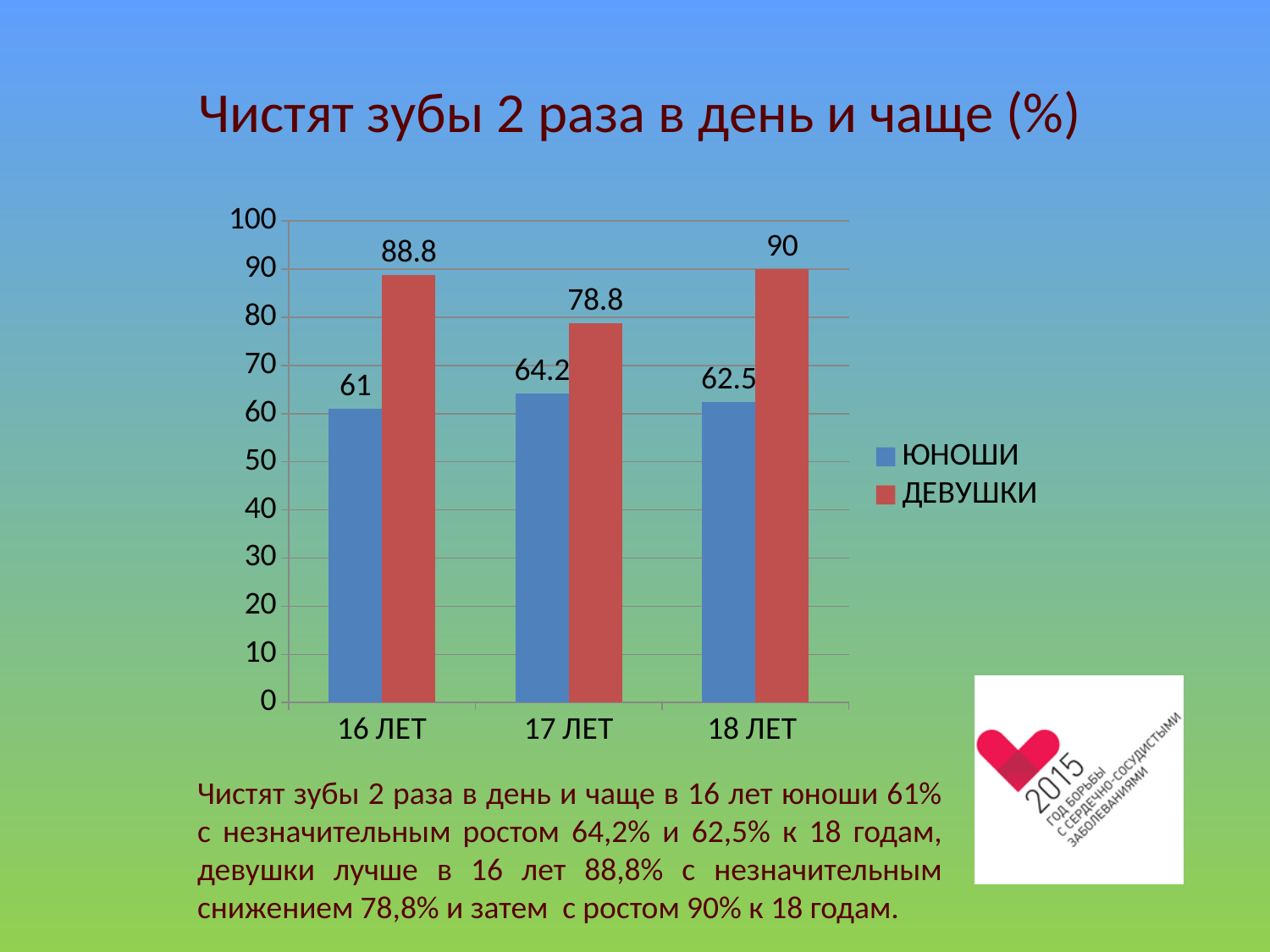
What kind of chart is shown on the slide? Bar chart What is the value for ДЕВУШКИ at 17 ЛЕТ? 78.8 What is the value for ЮНОШИ at 16 ЛЕТ? 61 What is the value for ЮНОШИ at 18 ЛЕТ? 62.5 What is the difference between ДЕВУШКИ and ЮНОШИ at 16 ЛЕТ? 27.8 What is the title of the slide? Чистят зубы 2 раза в день и чаще (%) How many age categories are shown on the x axis? 3 How many series does the legend list? 2 Which is larger at 17 ЛЕТ, ЮНОШИ or ДЕВУШКИ? ДЕВУШКИ What is the value for ДЕВУШКИ at 18 ЛЕТ? 90 Which age group has the lowest value for ЮНОШИ? 16 ЛЕТ Which age group has the highest value for ДЕВУШКИ? 18 ЛЕТ